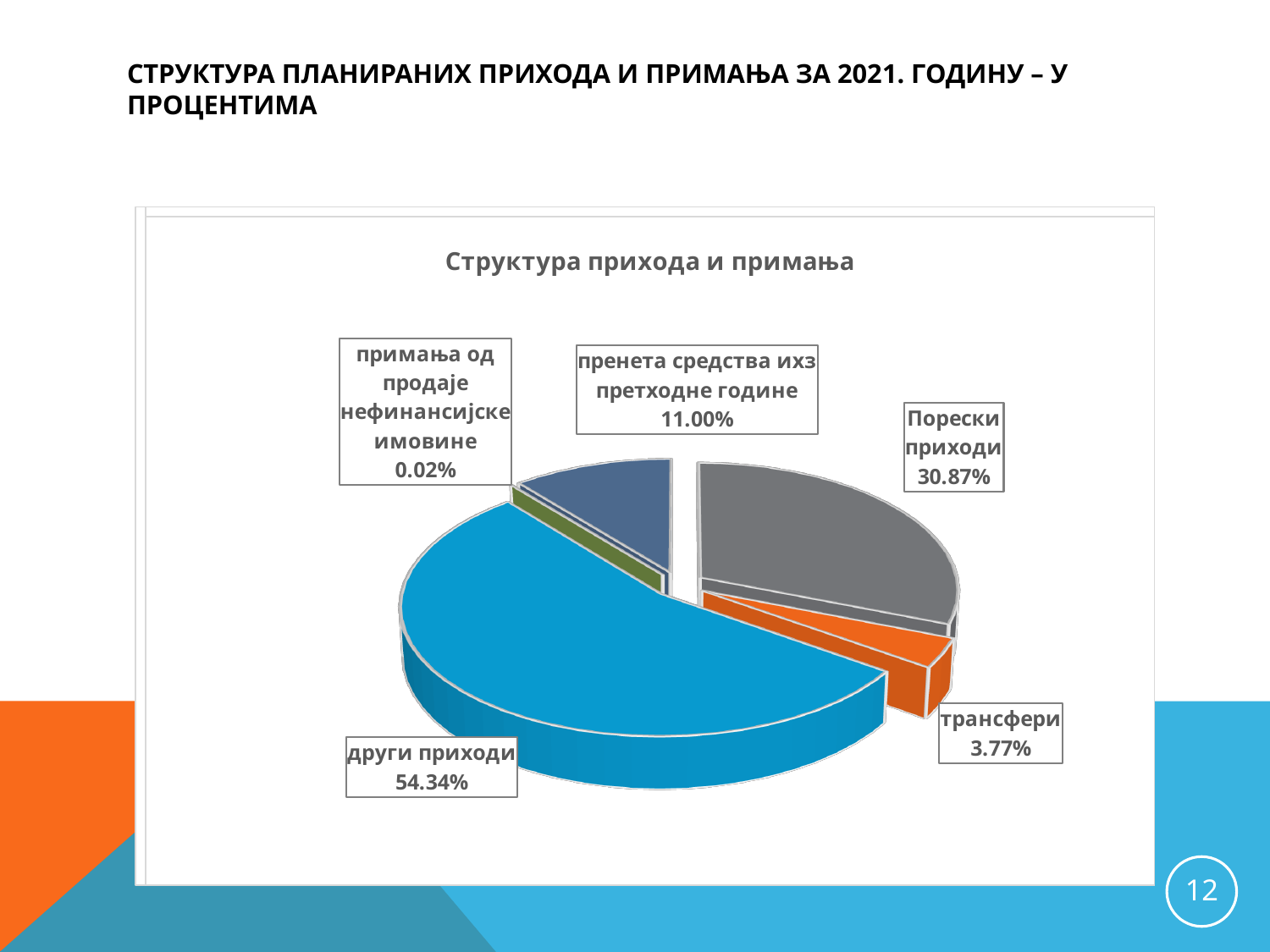
What share does "други приходи" have in the pie? 54.34% What kind of chart is shown on the slide? Pie chart What share does "Порески приходи" have in the pie? 30.87% What share does "примања од продаје нефинансијске имовине" have in the pie? 0.02% What is the difference between the shares of "други приходи" and "Порески приходи"? 23.47% Which is larger, the share of "пренета средства из претходне године" or the share of "трансфери"? пренета средства из претходне године What is the title of the chart? Структура прихода и примања What share does "трансфери" have in the pie? 3.77% Which category has the smallest share of the pie? примања од продаје нефинансијске имовине How many slices does the pie chart have? 5 What share does "пренета средства из претходне године" have in the pie? 11.00% Which category has the largest share of the pie? други приходи